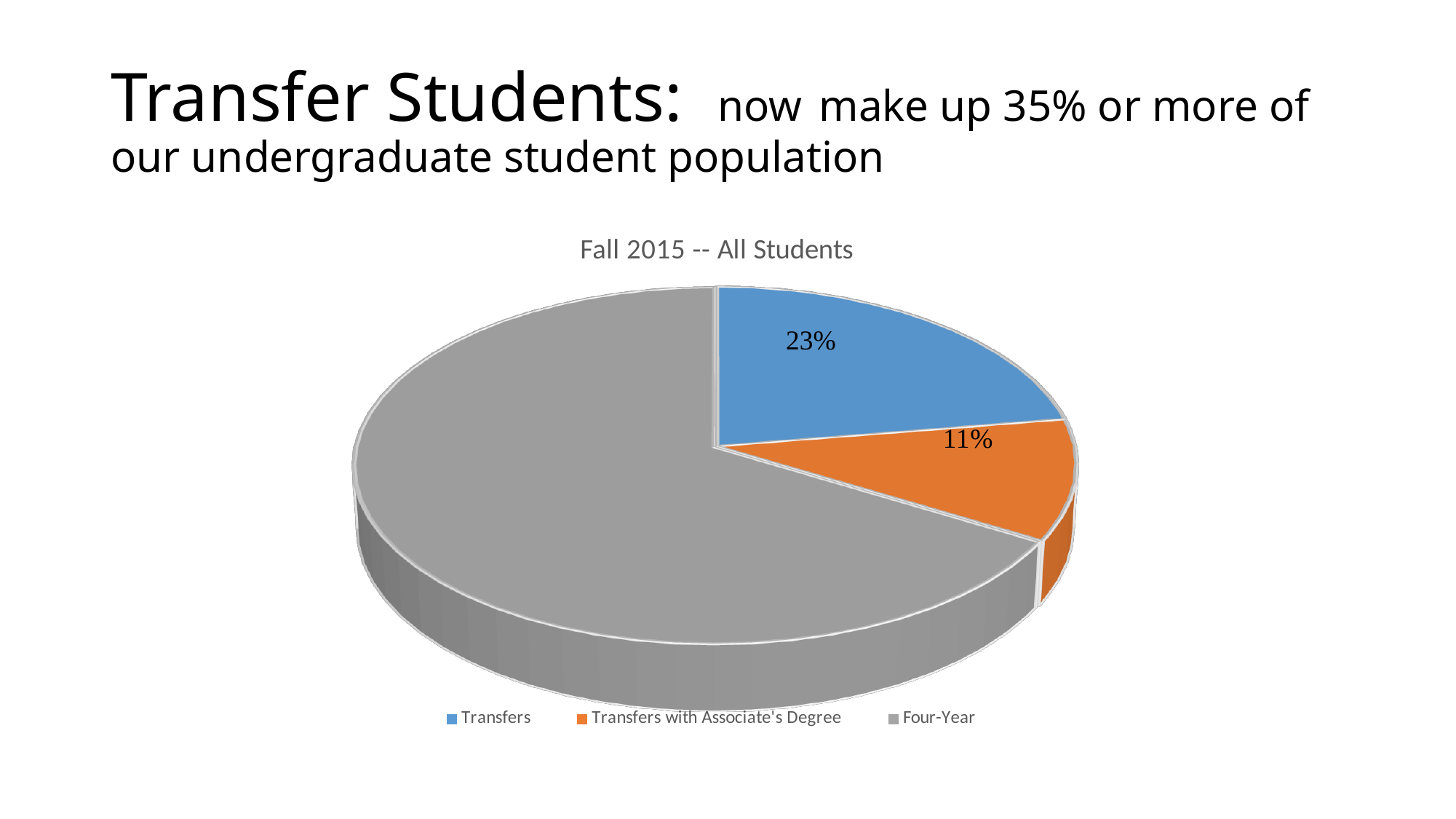
What percentage of the pie is labelled for Transfers with Associate's Degree? 11% How many entries does the legend list? 3 By how many percentage points does the Transfers slice exceed the Transfers with Associate's Degree slice? 12 percentage points What colour is the Four-Year slice in the pie chart? grey What share of the pie does the Transfers slice represent? 23% How many slices does the pie chart have? 3 Which is larger, the Transfers slice or the Transfers with Associate's Degree slice? Transfers Which category has the largest slice of the pie? Four-Year What percentage of the pie is labelled for Transfers? 23% What kind of chart is shown on the slide? pie chart What is the title of the chart? Fall 2015 -- All Students Which category has the smallest slice of the pie? Transfers with Associate's Degree